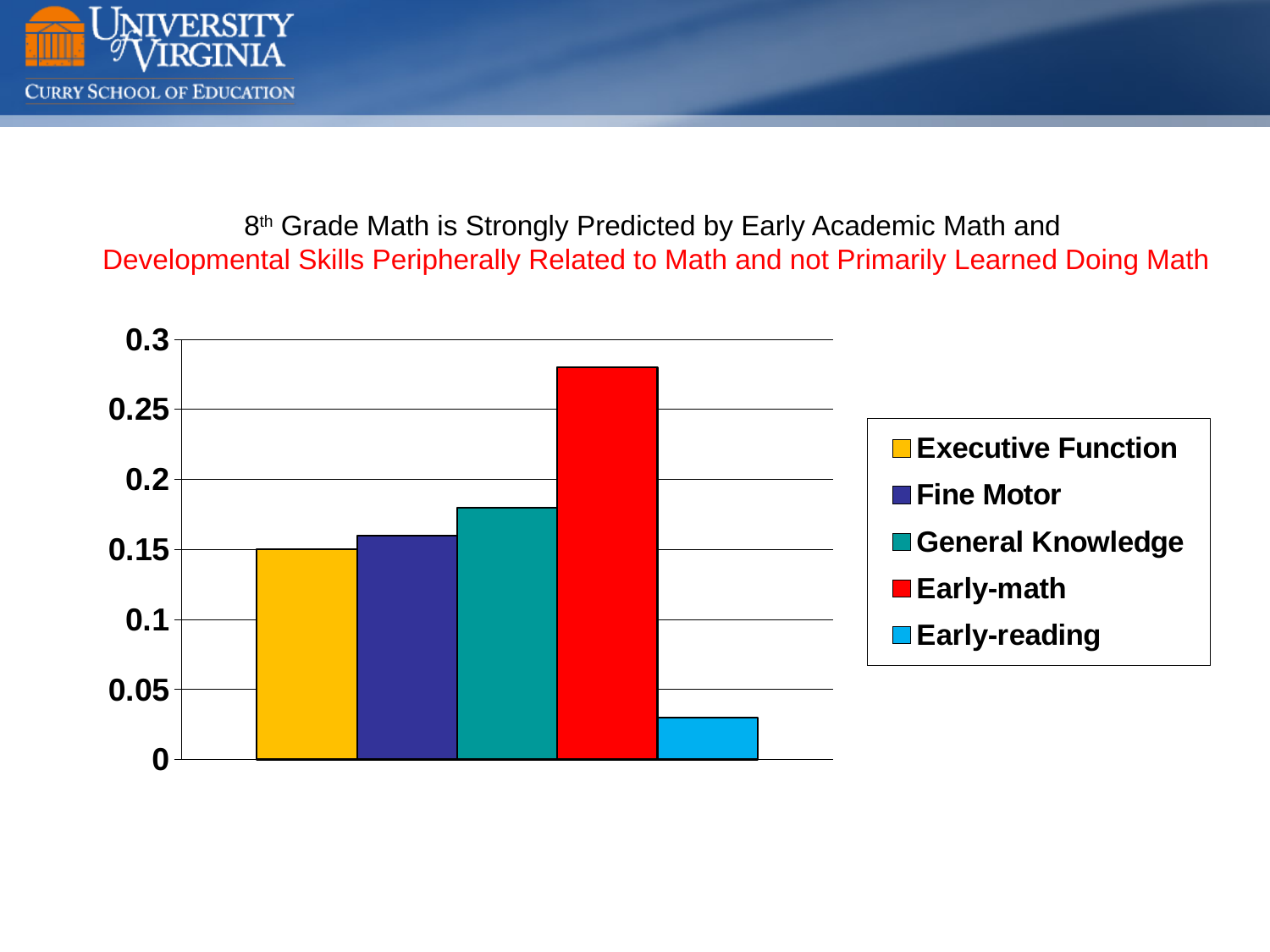
Which is larger, the value for Fine Motor or the value for General Knowledge? General Knowledge How many bars are plotted in the chart? 5 Is the value for Early-reading greater or less than 0.05? less Is the value for Fine Motor greater or less than 0.15? greater Is the value for General Knowledge greater or less than 0.2? less Which series has the highest bar? Early-math How many series does the legend list? 5 Which is larger, the value for Executive Function or the value for Early-math? Early-math What kind of chart is shown on the slide? bar chart Which series has the lowest bar? Early-reading What colour is the Early-math bar? red